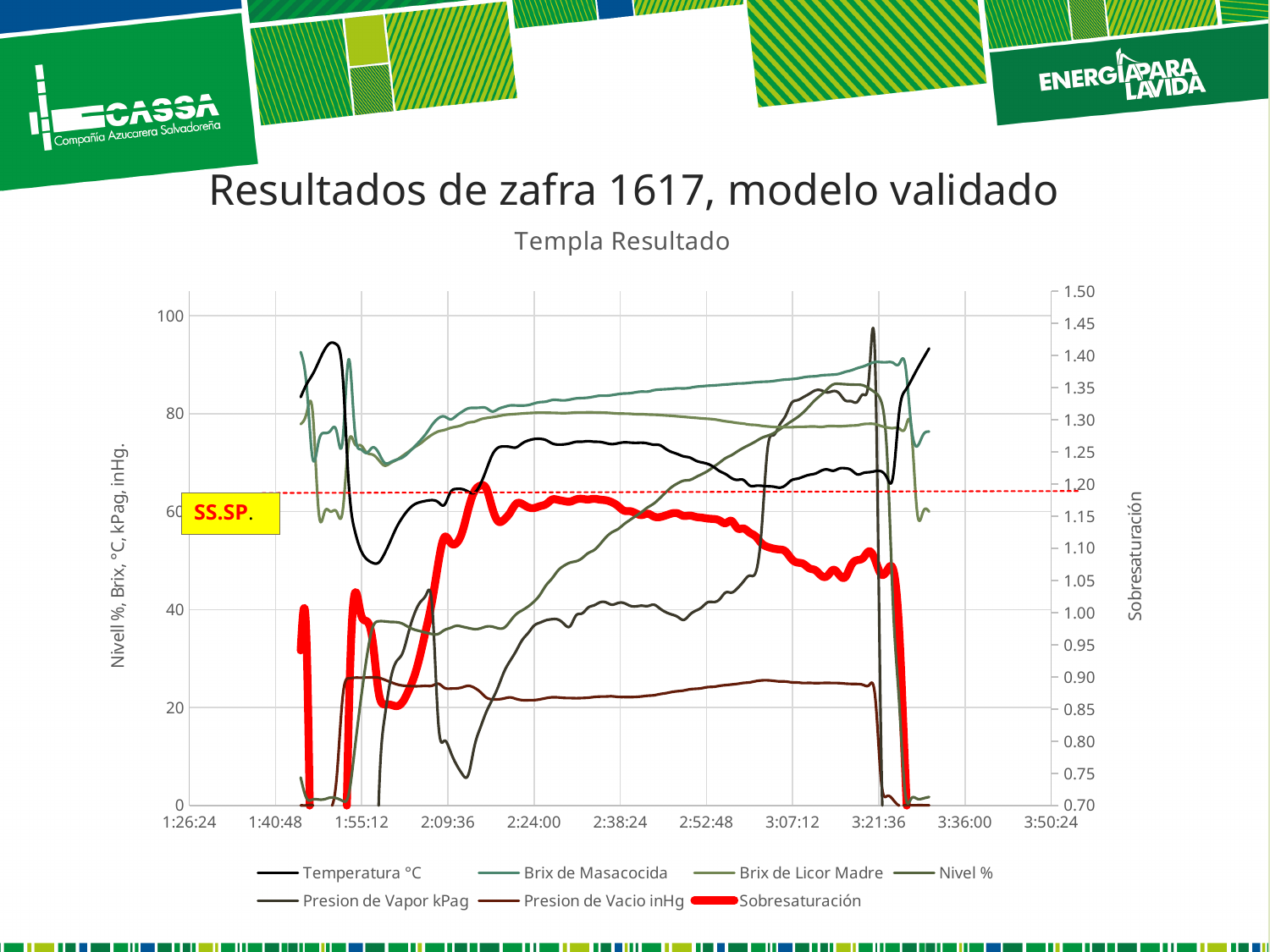
Does the Brix de Masacocida series generally rise or fall between 2:09:36 and 3:21:36? rise What is the title of the chart? Templa Resultado Is the value of Brix de Masacocida at 3:07:12 greater or less than 80? greater Is the value of Presion de Vacio inHg at 2:52:48 greater or less than 40? less Is the value of Sobresaturación at 2:38:24 greater or less than 1.20 on the right axis? less What is the label of the right-hand vertical axis? Sobresaturación How many series does the chart legend list? 7 Does the Nivel % series generally rise or fall between 2:09:36 and 3:07:12? rise What type of chart is shown on the slide? line chart What is the maximum value shown on the right-hand vertical axis? 1.50